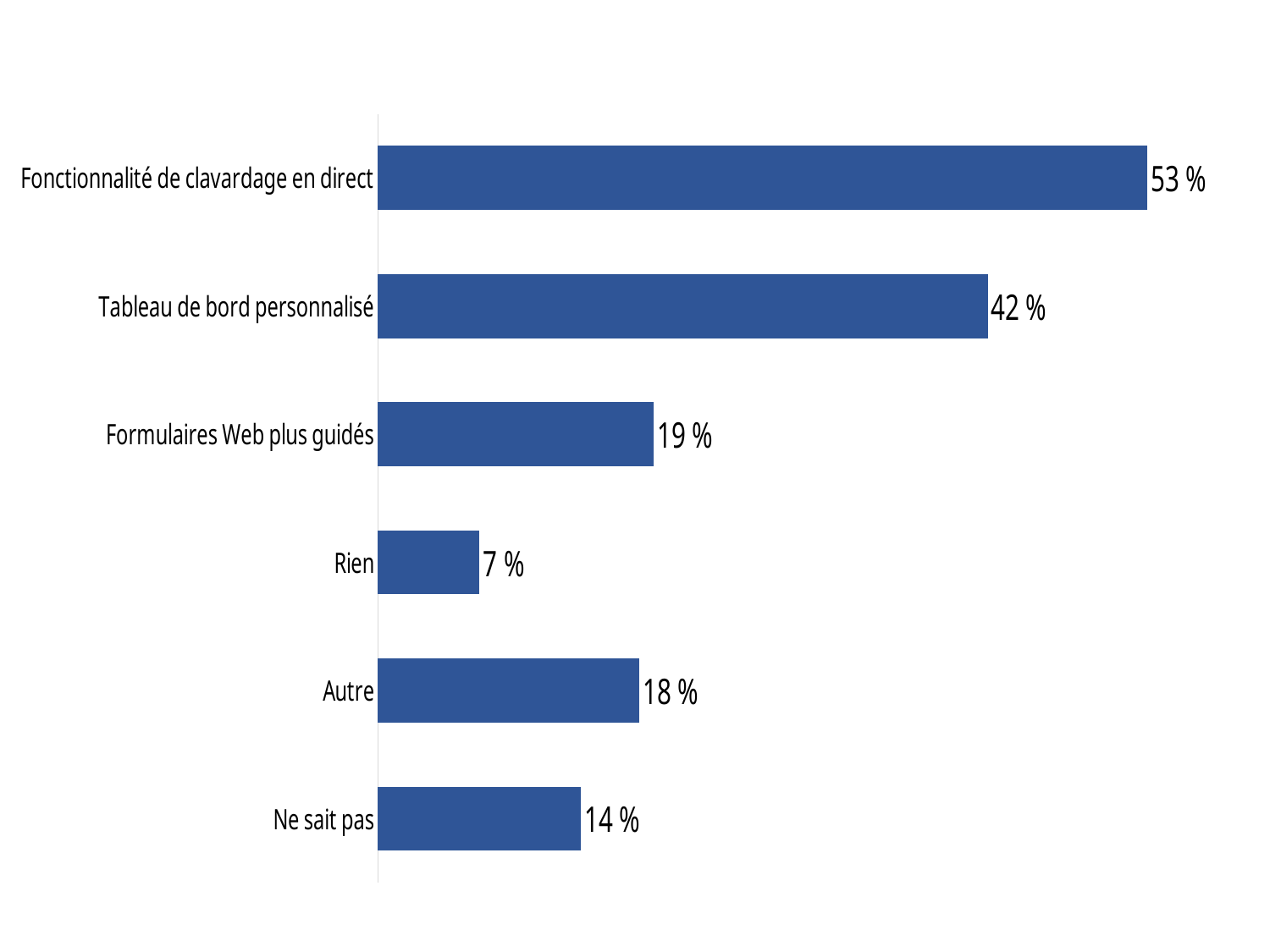
What is the value for Formulaires Web plus guidés? 19 % What is the value for Fonctionnalité de clavardage en direct? 53 % Which category has the highest value? Fonctionnalité de clavardage en direct What is the value for Tableau de bord personnalisé? 42 % What is the difference between the values for Autre and Ne sait pas? 4 % What is the value for Ne sait pas? 14 % Which category has the lowest value? Rien Which is larger, the value for Formulaires Web plus guidés or the value for Autre? Formulaires Web plus guidés What is the value for Rien? 7 % What is the difference between the values for Fonctionnalité de clavardage en direct and Tableau de bord personnalisé? 11 % What kind of chart is this? Bar chart How many categories are shown in the chart? 6